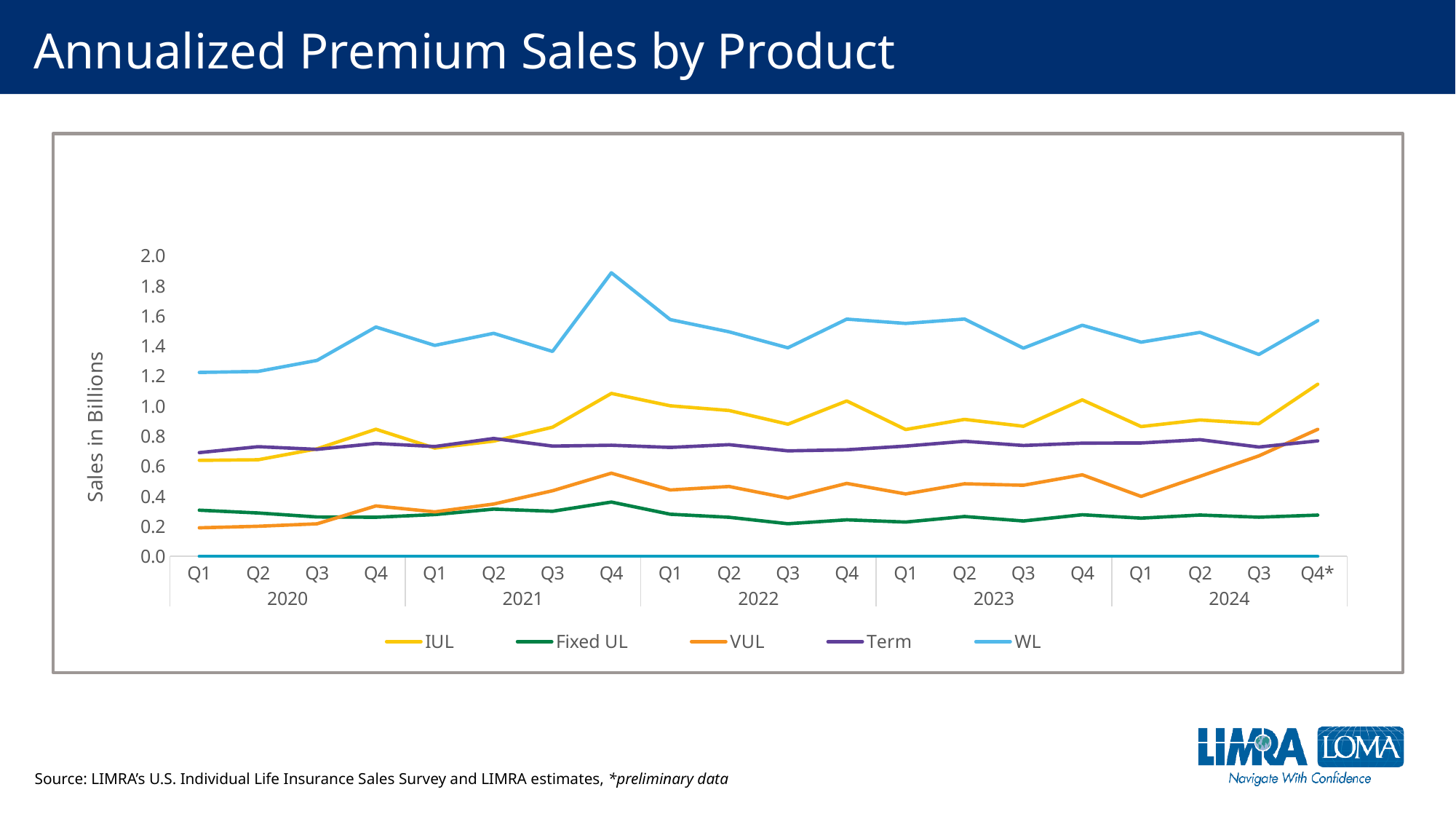
Is the value for WL in Q4 2021 greater or less than 1.8? greater How many series does the legend list? 5 How many quarters are plotted along the x axis? 20 Is the value for IUL in Q4* 2024 greater or less than 1.0? greater Does the VUL series rise or fall from Q1 2024 to Q4* 2024? rise In Q1 2020, which is larger, Term or IUL? Term In which quarter does the WL series reach its peak? Q4 2021 Which product series has the highest values across the whole period? WL Is the value for Fixed UL in Q1 2020 greater or less than 0.4? less What type of chart is shown on the slide? line chart Which product series has the lowest values during 2024? Fixed UL What is the label on the y axis? Sales in Billions